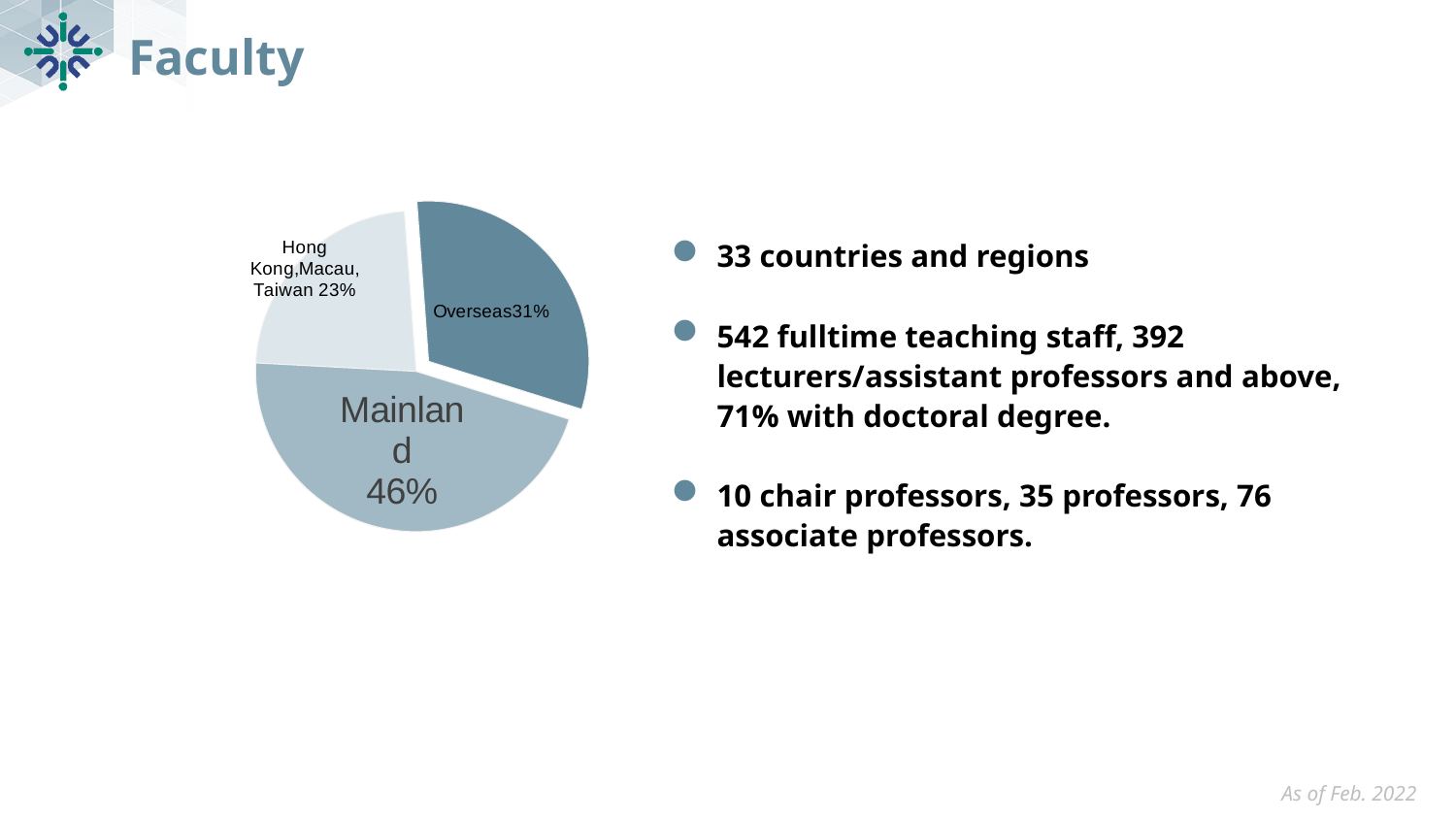
What is the difference in percentage points between the Overseas and Hong Kong, Macau, Taiwan slices? 8 What share of the pie does Mainland represent? 46% Which slice of the pie chart is shown in the darkest colour? Overseas What kind of chart is shown on the slide? pie chart Which slice of the pie chart is the smallest? Hong Kong, Macau, Taiwan How many slices does the pie chart have? 3 What is the difference in percentage points between the Mainland and Overseas slices? 15 What share of the pie does Hong Kong, Macau, Taiwan represent? 23% Which is larger, the Mainland slice or the Overseas slice? Mainland Which slice of the pie chart is the largest? Mainland What share of the pie does Overseas represent? 31% Which is larger, the Overseas slice or the Hong Kong, Macau, Taiwan slice? Overseas